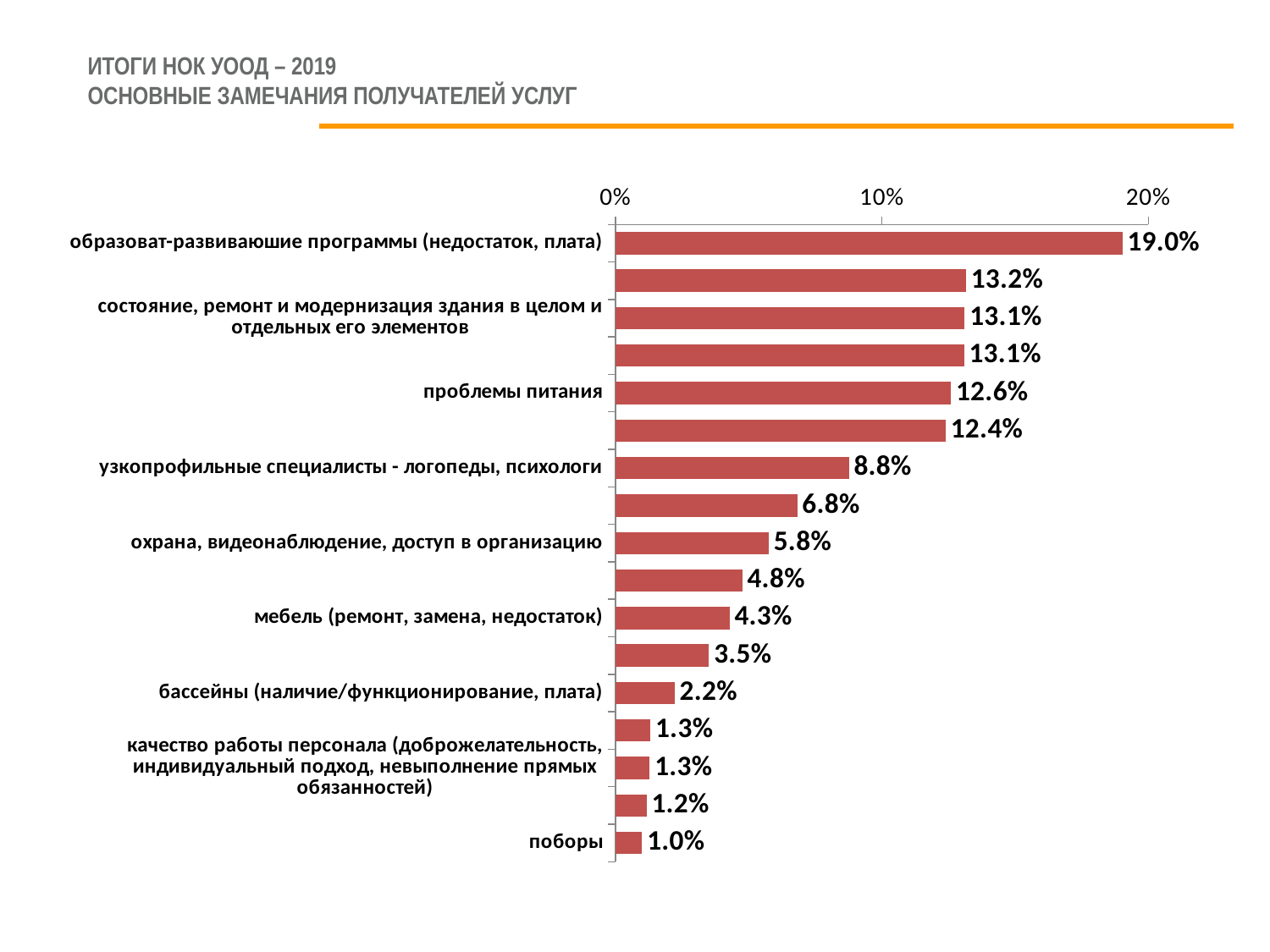
What is the value for "бассейны (наличие/функционирование, плата)"? 2.2% What is the value for "проблемы питания"? 12.6% How many bars are plotted in the chart? 17 What is the value for "мебель (ремонт, замена, недостаток)"? 4.3% Which is larger, the value for "охрана, видеонаблюдение, доступ в организацию" or the value for "мебель (ремонт, замена, недостаток)"? охрана, видеонаблюдение, доступ в организацию What is the value for "узкопрофильные специалисты - логопеды, психологи"? 8.8% Which category has the highest value? образоват-развивающие программы (недостаток, плата) Which category has the lowest value? поборы What is the value for "образоват-развивающие программы (недостаток, плата)"? 19.0% What is the difference between the values for "образоват-развивающие программы (недостаток, плата)" and "проблемы питания"? 6.4% What kind of chart is shown on the slide? bar chart What is the value for "охрана, видеонаблюдение, доступ в организацию"? 5.8%